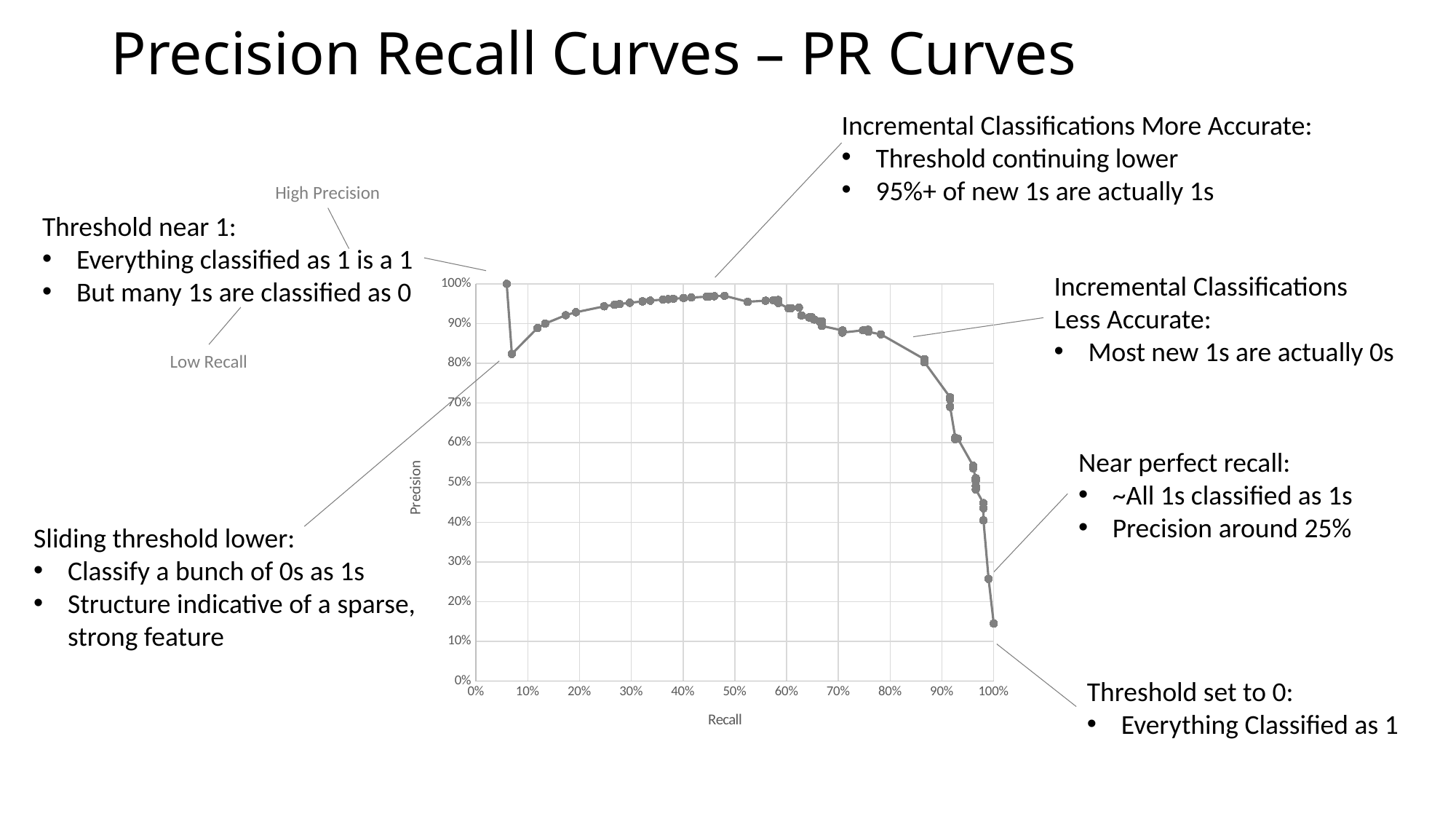
What is the highest precision value reached by the curve? 100% Is the precision at 30% recall greater or less than 90%? greater Is the precision at 90% recall greater or less than 80%? less Which has the higher precision: the point at about 30% recall or the point at about 95% recall? 30% recall What is the highest tick value shown on the y axis? 100% What kind of chart is shown on the slide? line chart As recall increases from 60% to 100%, does precision rise or fall? fall Is the precision at 100% recall greater or less than 20%? less What is the label of the x axis of the chart? Recall At which recall value does the curve reach its lowest precision? 100% What is the label of the y axis of the chart? Precision